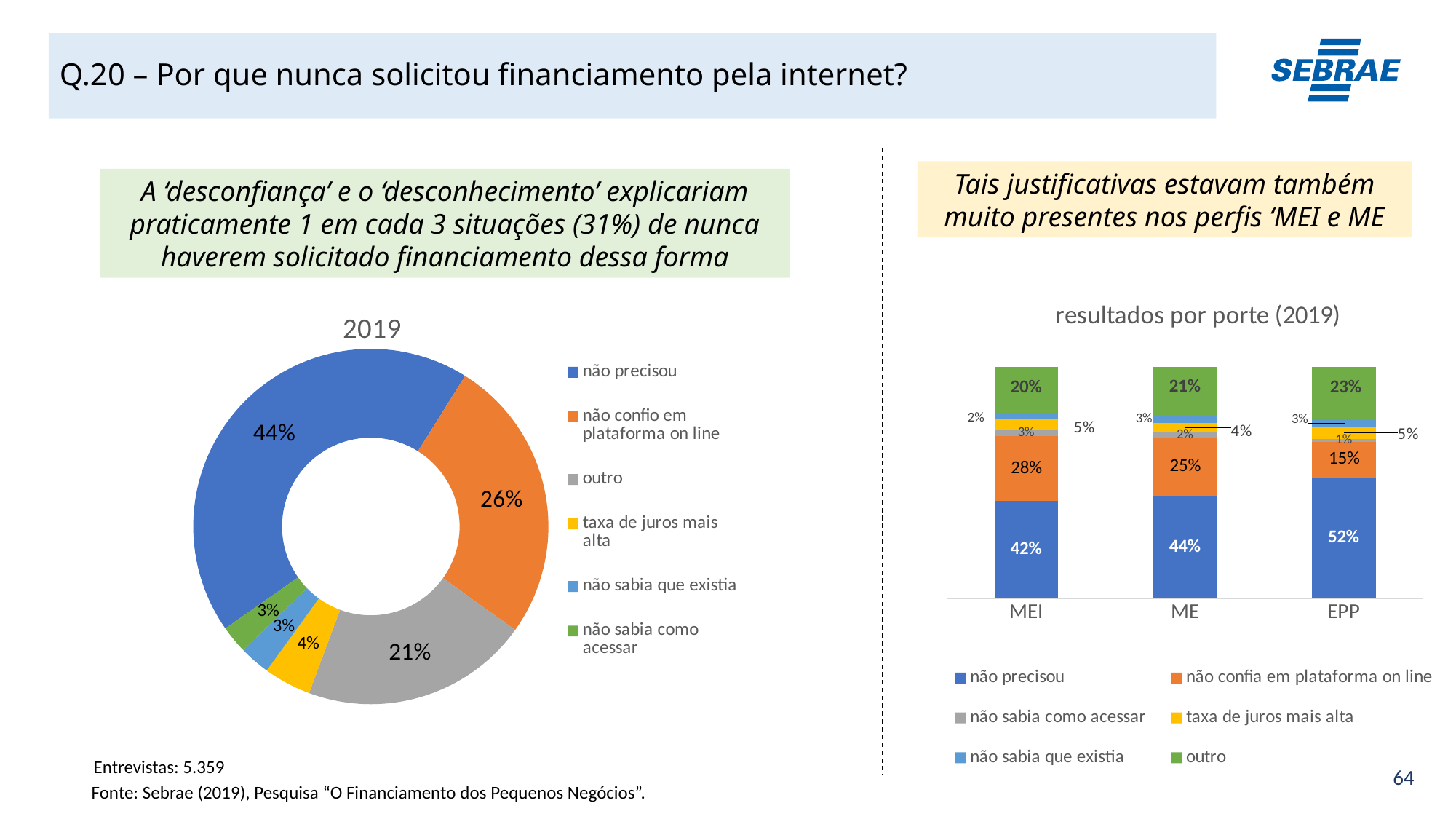
On the donut chart titled 2019, which category has the largest share? não precisou What kind of chart is the chart titled 2019 on the left of the slide? Donut (pie) chart On the chart 'resultados por porte (2019)', what is the value of 'não precisou' for EPP? 52% On the chart 'resultados por porte (2019)', which is larger: 'outro' for MEI or 'outro' for EPP? EPP On the donut chart titled 2019, what share is 'não confio em plataforma on line'? 26% On the chart 'resultados por porte (2019)', how many series does the legend list? 6 On the chart 'resultados por porte (2019)', what is the value of 'não confia em plataforma on line' for MEI? 28% On the donut chart titled 2019, what share is 'não precisou'? 44% On the chart 'resultados por porte (2019)', which porte has the highest value for 'não precisou'? EPP On the donut chart titled 2019, how many categories does the legend list? 6 On the donut chart titled 2019, what is the difference between the shares of 'não precisou' and 'outro'? 23% On the chart 'resultados por porte (2019)', what is the difference between 'não confia em plataforma on line' for ME and for EPP? 10%